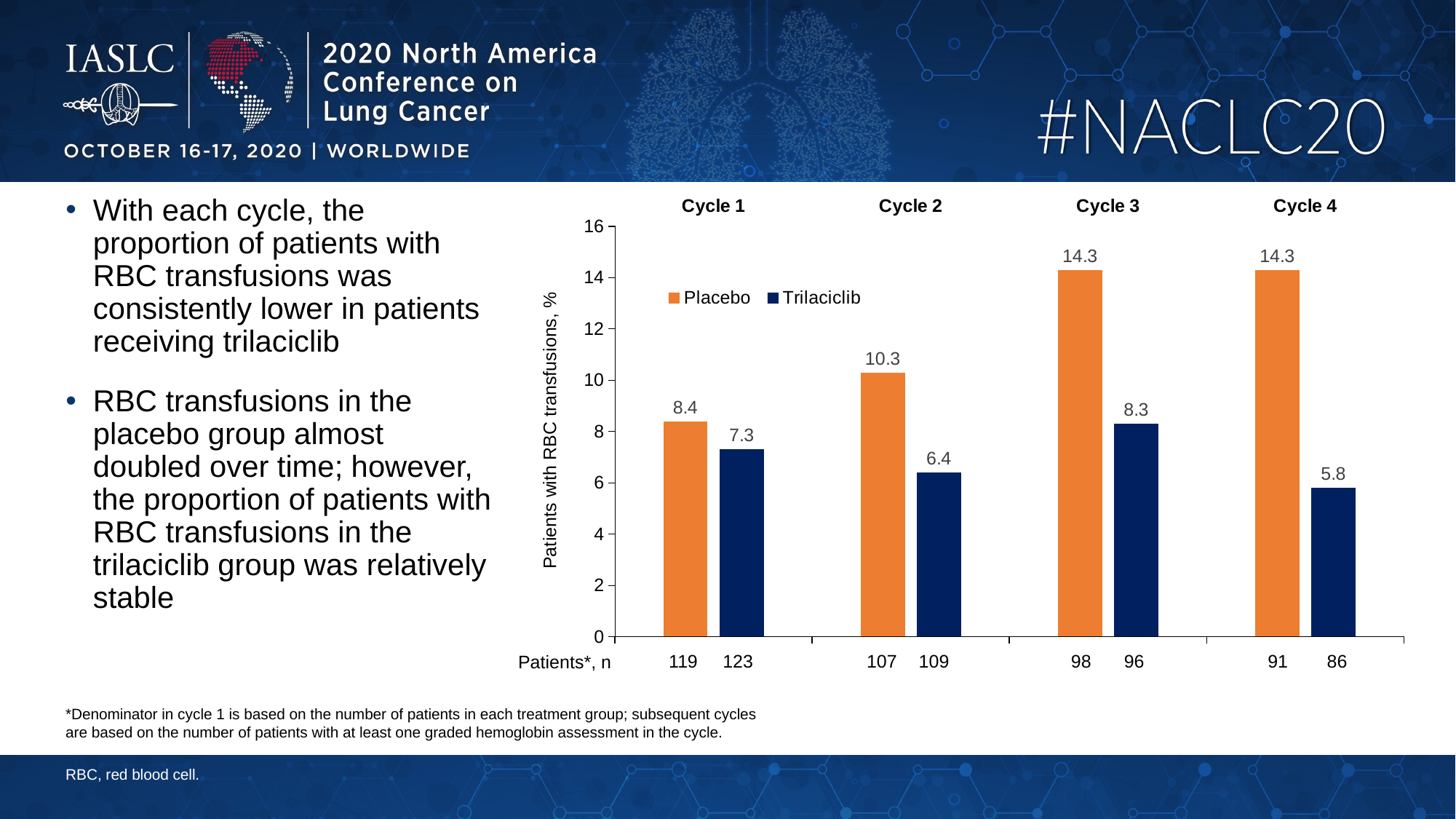
Does the placebo group's percentage of patients with RBC transfusions rise or fall from Cycle 1 to Cycle 3? Rise How many cycles are shown on the x axis of the chart? 4 What is the difference between the placebo and trilaciclib percentages in Cycle 4? 8.5 What is the percentage of patients with RBC transfusions in the trilaciclib group in Cycle 4? 5.8 What is the percentage of patients with RBC transfusions in the trilaciclib group in Cycle 2? 6.4 In which cycle is the trilaciclib group's percentage of patients with RBC transfusions highest? Cycle 3 What kind of chart is used to show patients with RBC transfusions? Bar chart Which group has the higher percentage of patients with RBC transfusions in Cycle 2? Placebo What is the percentage of patients with RBC transfusions in the placebo group in Cycle 1? 8.4 In which cycle is the placebo group's percentage of patients with RBC transfusions lowest? Cycle 1 What is the difference between the placebo percentages in Cycle 3 and Cycle 1? 5.9 How many series does the chart legend list? 2